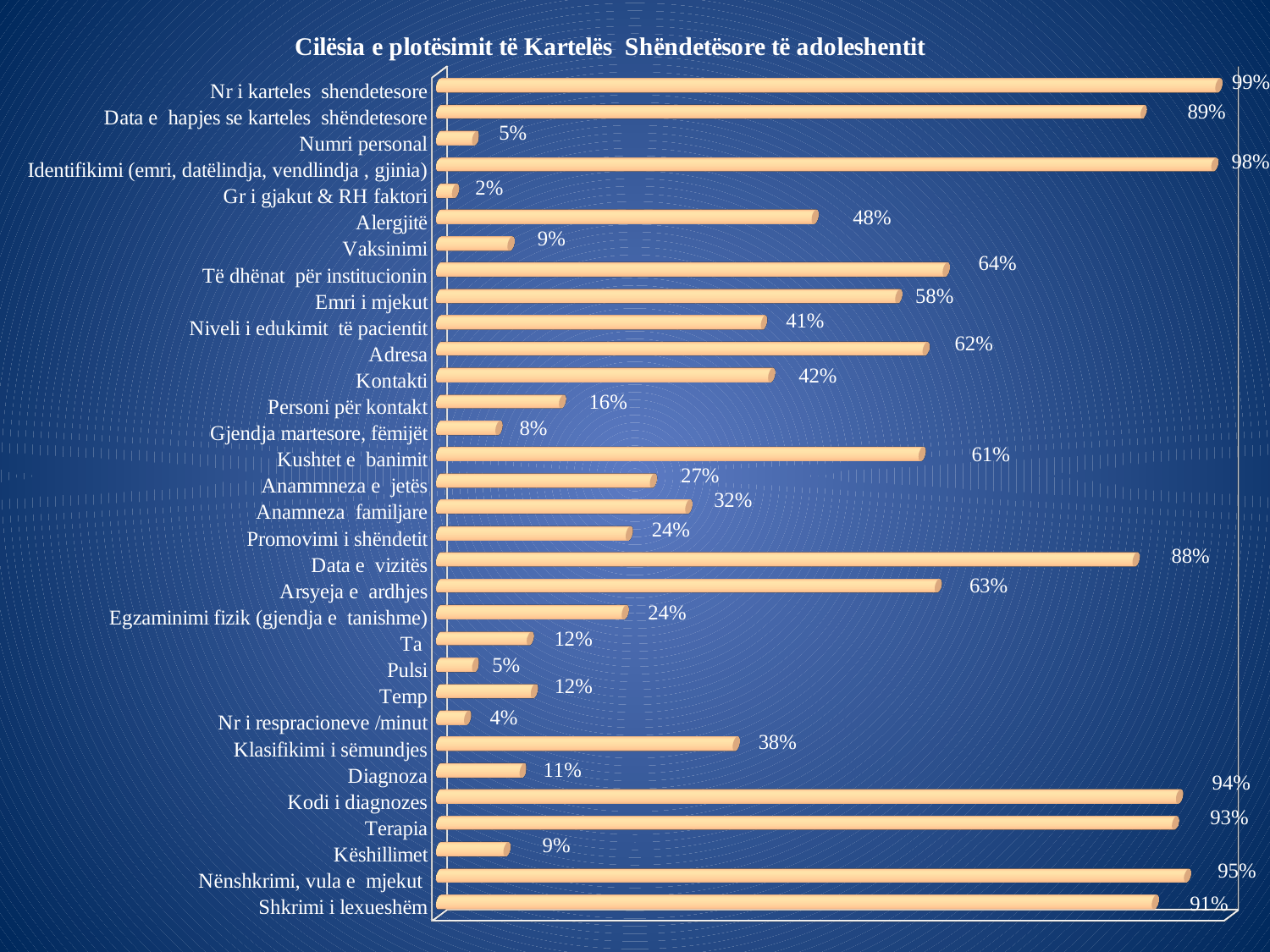
What is the title of the chart? Cilësia e plotësimit të Kartelës Shëndetësore të adoleshentit What is the value for Alergjitë? 48% What is the value for Data e vizitës? 88% Which category has the highest value? Nr i karteles shendetesore Which is larger, the value for Emri i mjekut or the value for Niveli i edukimit të pacientit? Emri i mjekut What is the value for Kodi i diagnozes? 94% What is the difference between the values for Adresa and Kontakti? 20% What is the difference between the values for Terapia and Këshillimet? 84% How many categories are shown in the chart? 32 What kind of chart is shown on the slide? Bar chart Which category has the lowest value? Gr i gjakut & RH faktori What is the value for Klasifikimi i sëmundjes? 38%